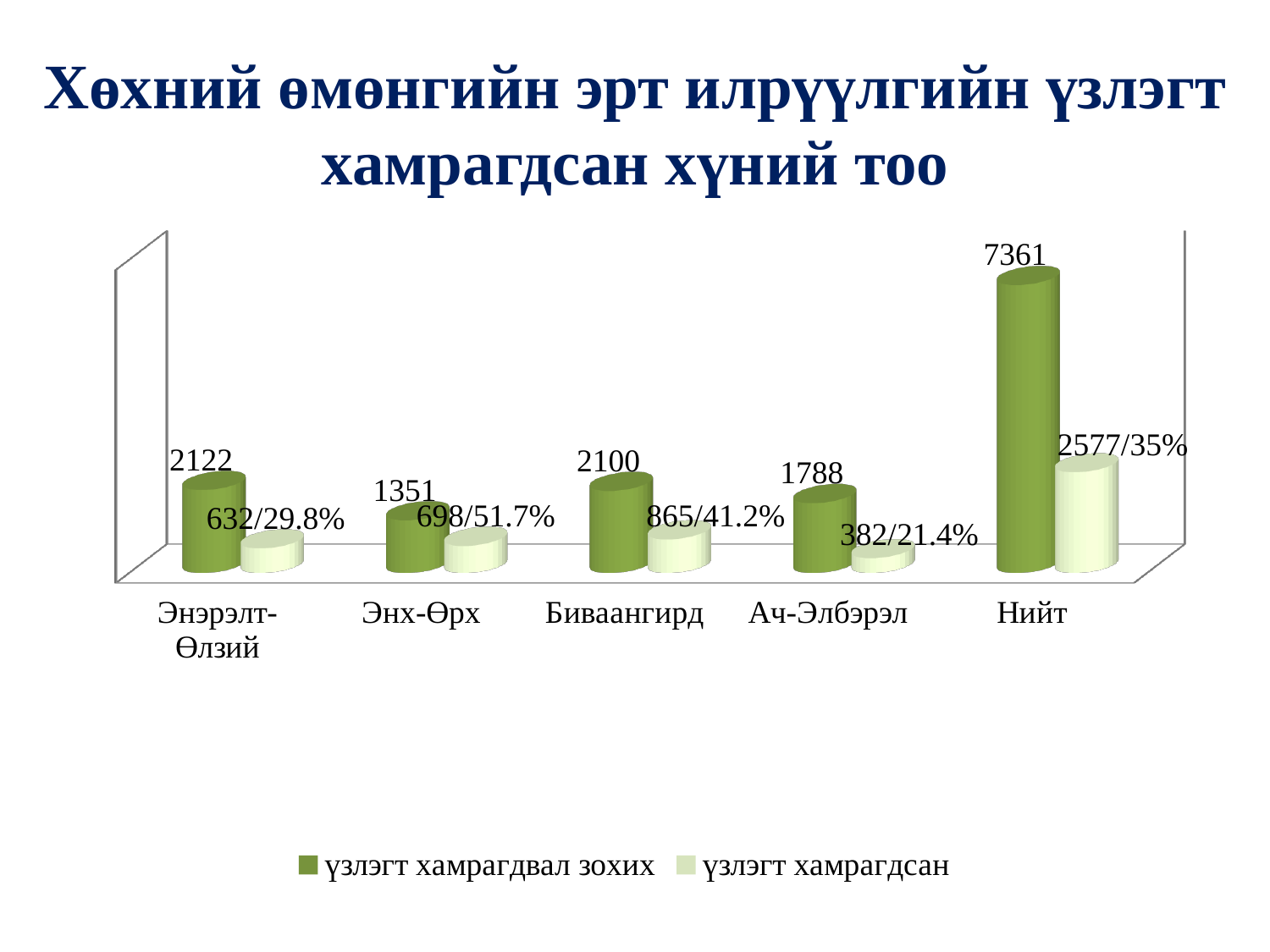
What kind of chart is shown on the slide? Bar chart What data label is shown for Нийт in the үзлэгт хамрагдсан series? 2577/35% What is the difference between the үзлэгт хамрагдвал зохих value (2122) and the үзлэгт хамрагдсан count (632) for Энэрэлт-Өлзий? 1490 What is the value for Энэрэлт-Өлзий in the үзлэгт хамрагдвал зохих series? 2122 What is the value for Ач-Элбэрэл in the үзлэгт хамрагдвал зохих series? 1788 How many categories are shown on the x axis? 5 What data label is shown for Биваангирд in the үзлэгт хамрагдсан series? 865/41.2% Which category has the lowest value in the үзлэгт хамрагдсан series? Ач-Элбэрэл Which category has the lowest value in the үзлэгт хамрагдвал зохих series? Энх-Өрх Which category has the highest value in the үзлэгт хамрагдвал зохих series? Нийт Which has a larger үзлэгт хамрагдвал зохих value, Энх-Өрх or Ач-Элбэрэл? Ач-Элбэрэл How many series does the legend list? 2